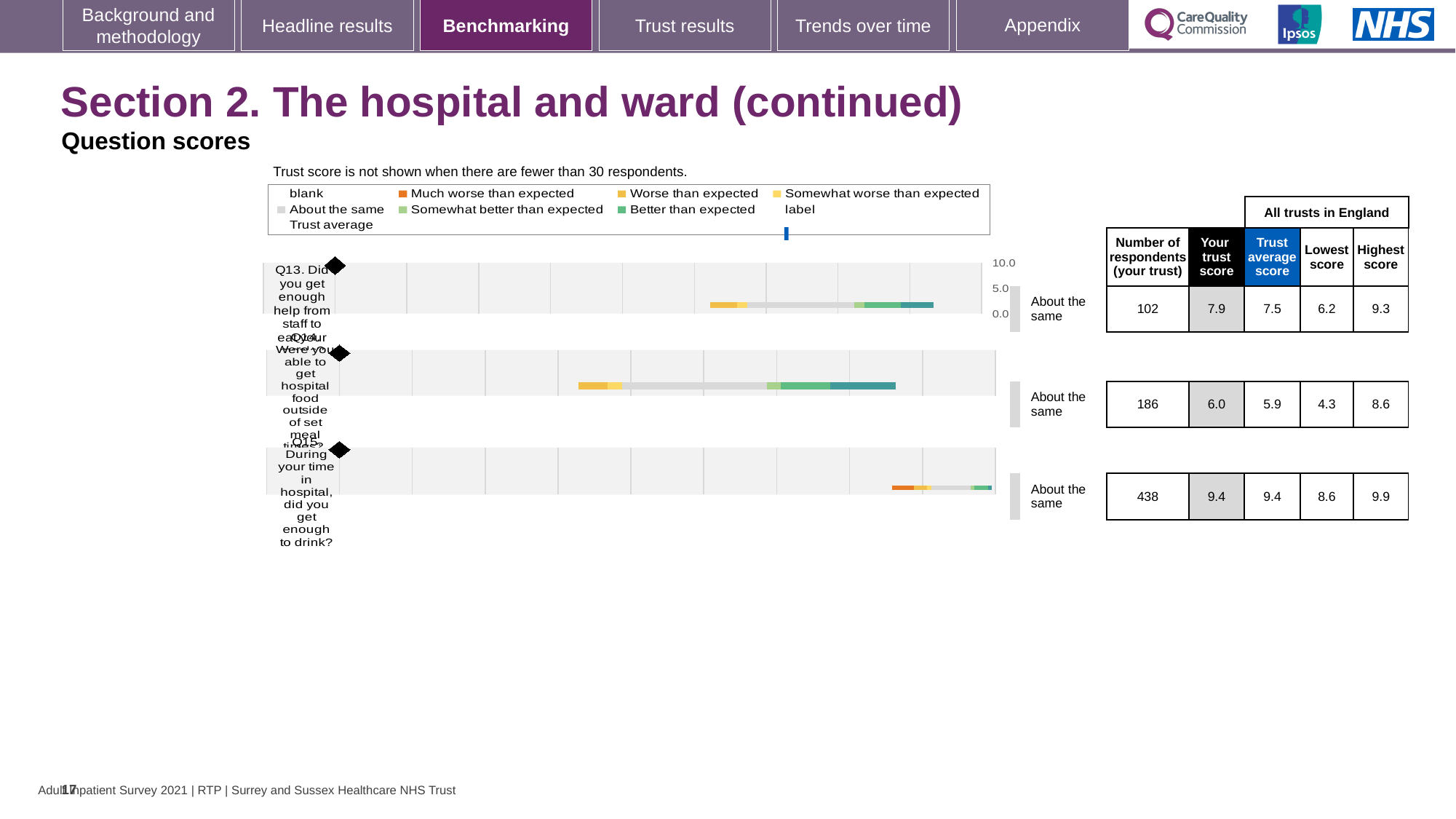
Which question has the highest trust score? Q15 What is the highest score across all trusts in England for Q15? 9.9 What kind of chart is used to show the question scores for Q13, Q14 and Q15? Bar chart What is the difference between the trust score and the trust average score for Q13? 0.4 For Q14, which is larger: the trust score or the trust average score? Trust score Which question has the lowest trust average score? Q14 What is the trust score for Q13 (Did you get enough help from staff to eat your meals?)? 7.9 How many questions (Q13, Q14, Q15) are plotted on the slide? 3 What benchmark category is shown for Q13? About the same According to the note above the chart, below how many respondents is the trust score not shown? 30 What is the difference between the highest score and the lowest score for Q14? 4.3 How many respondents answered Q14 (Were you able to get hospital food outside of set meal times?)? 186